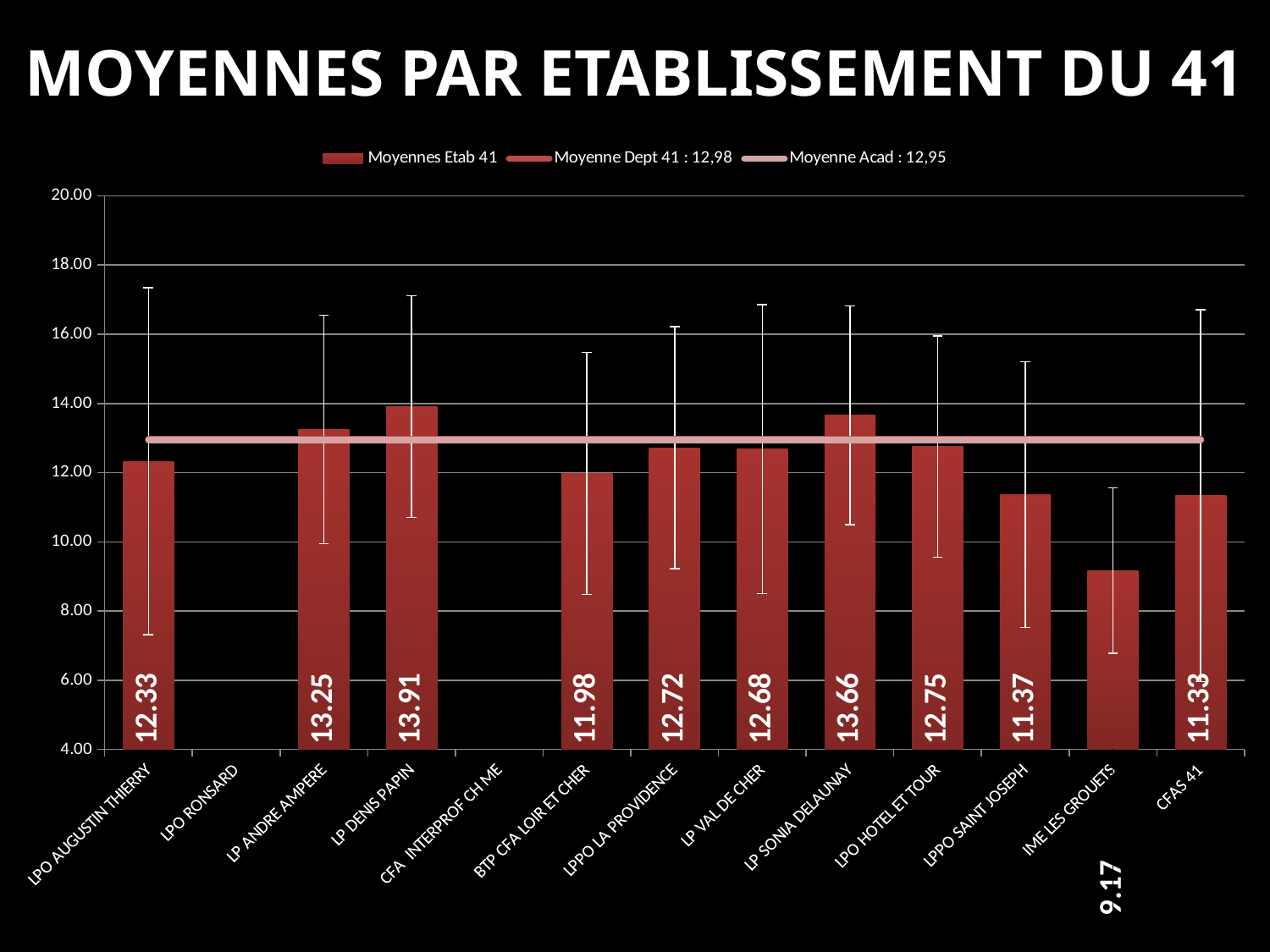
What kind of chart is shown on the slide? combination bar and line chart How many series does the legend list? 3 What is the value for LP DENIS PAPIN? 13.91 How many categories are listed on the x axis? 13 Which is larger, the value for LP ANDRE AMPERE or LP SONIA DELAUNAY? LP SONIA DELAUNAY According to the legend, what is the value of Moyenne Dept 41? 12,98 Which establishment has the lowest average? IME LES GROUETS What is the value for LPPO SAINT JOSEPH? 11.37 What is the value for IME LES GROUETS? 9.17 What is the difference between the values for LPPO LA PROVIDENCE and LP VAL DE CHER? 0.04 Which establishment has the highest average? LP DENIS PAPIN What is the difference between the values for LP DENIS PAPIN and IME LES GROUETS? 4.74